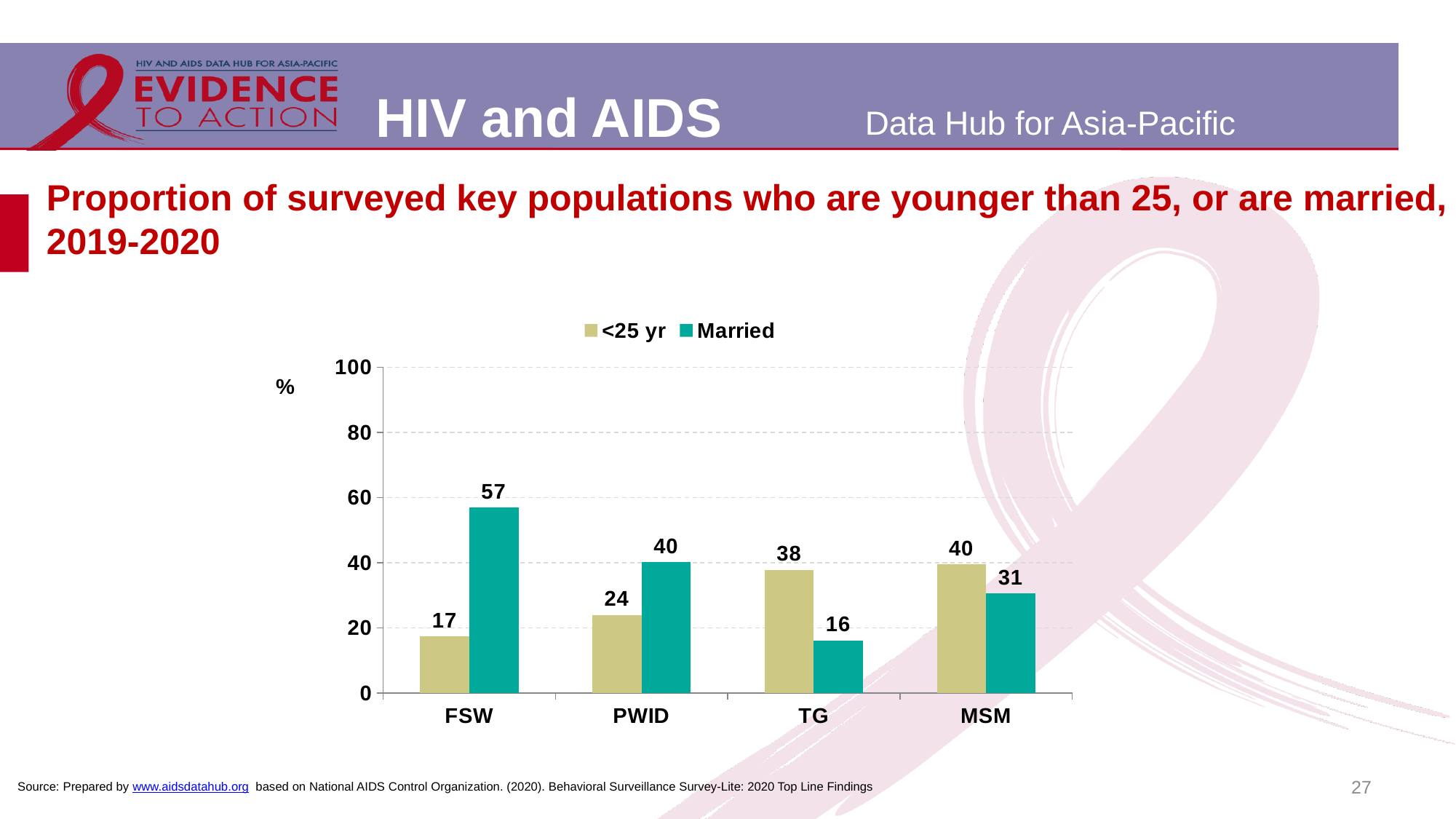
Which key population has the highest Married value? FSW What kind of chart is shown on the slide? bar chart Which is larger for PWID: the <25 yr value or the Married value? Married What is the value for <25 yr among TG? 38 Is the Married value for TG greater or less than 20? less What unit is shown on the y axis label? % How many series does the legend list? 2 How many key populations are shown on the x axis? 4 What is the value for Married among MSM? 31 What is the value for Married among FSW? 57 What is the difference between the Married and <25 yr values for FSW? 40 Which key population has the lowest <25 yr value? FSW